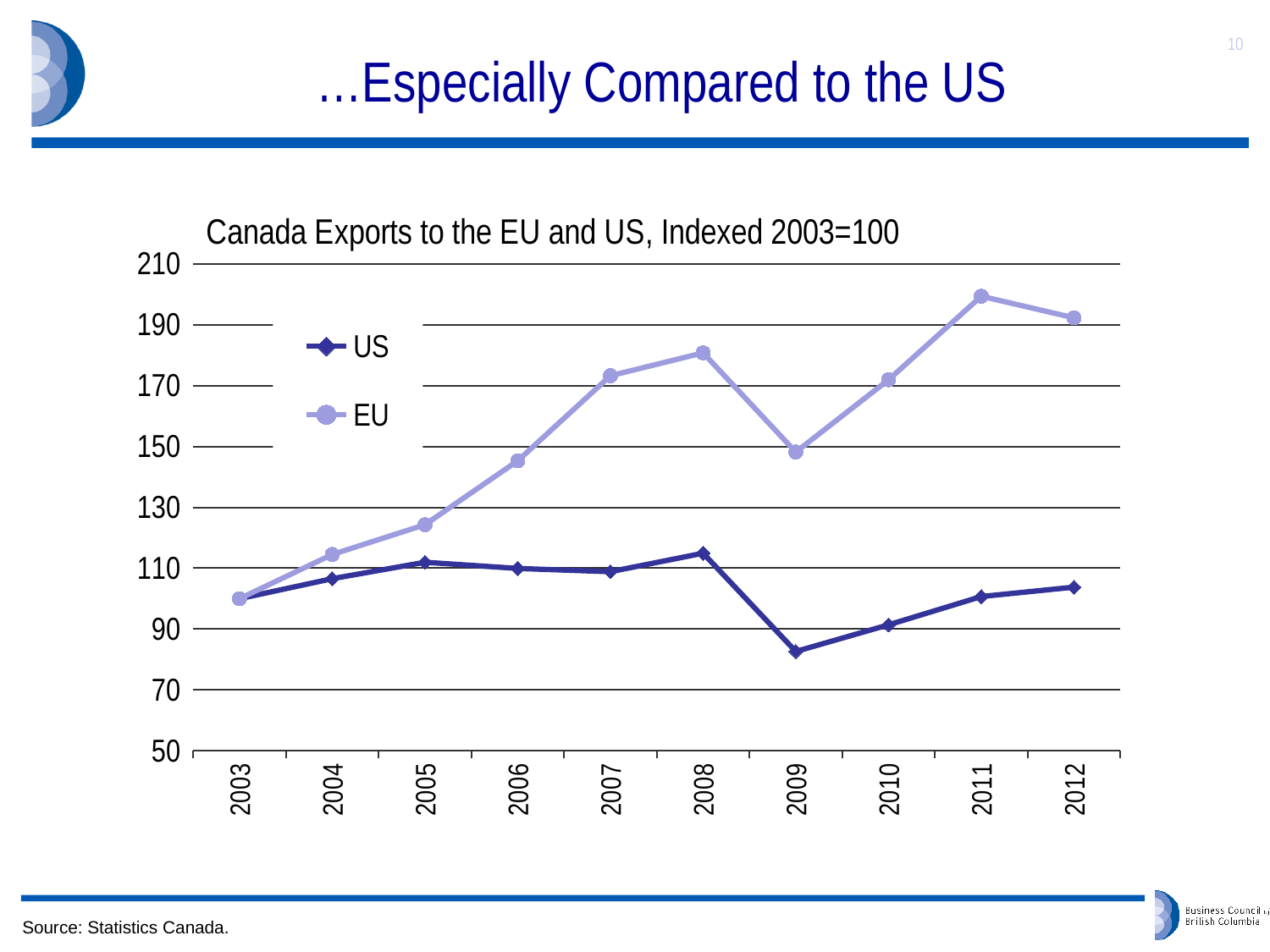
Is the EU value for 2005 greater or less than 130? less In which year does the EU series reach its highest value? 2011 Which series has the higher value in 2012, US or EU? EU What is the title of the chart? Canada Exports to the EU and US, Indexed 2003=100 Is the EU value for 2011 greater or less than 190? greater Is the US value for 2009 greater or less than 90? less How many years are plotted along the x axis? 10 In which year does the US series reach its lowest value? 2009 Does the EU series rise or fall from 2009 to 2011? rise What is the indexed value for both the US and EU series in 2003? 100 What kind of chart is shown on the slide? line chart How many series does the legend list? 2